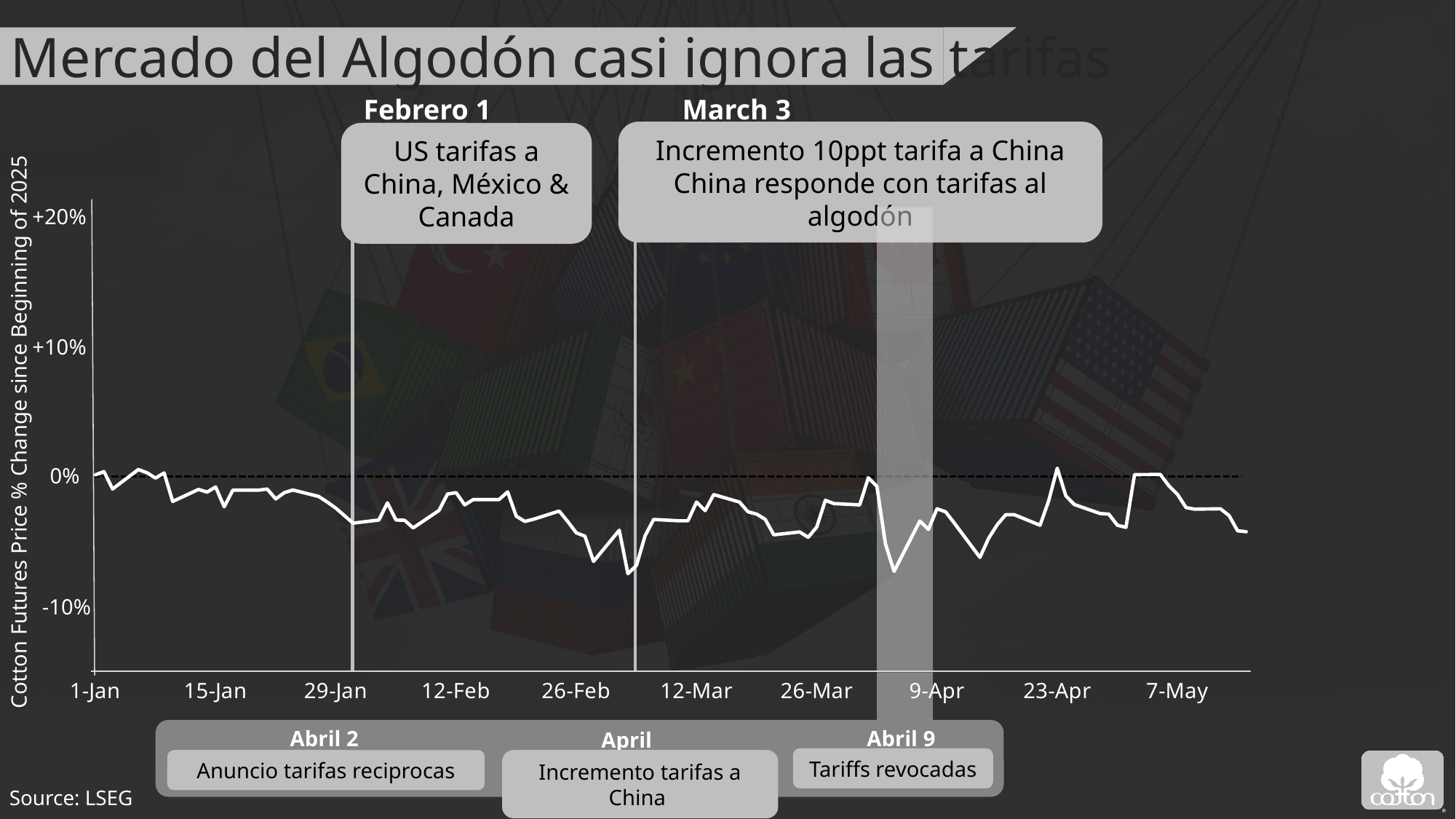
How many date labels are shown on the horizontal axis? 10 Is the value on 9-Apr greater or less than -10%? greater What kind of chart is shown on the slide? line chart Is the value on 26-Mar greater or less than +10%? less Is the value on 7-May greater or less than -10%? greater Overall, does the line rise or fall from 1-Jan to the end of the period shown? fall What is the label on the vertical axis of the chart? Cotton Futures Price % Change since Beginning of 2025 What is the title of the slide? Mercado del Algodón casi ignora las tarifas